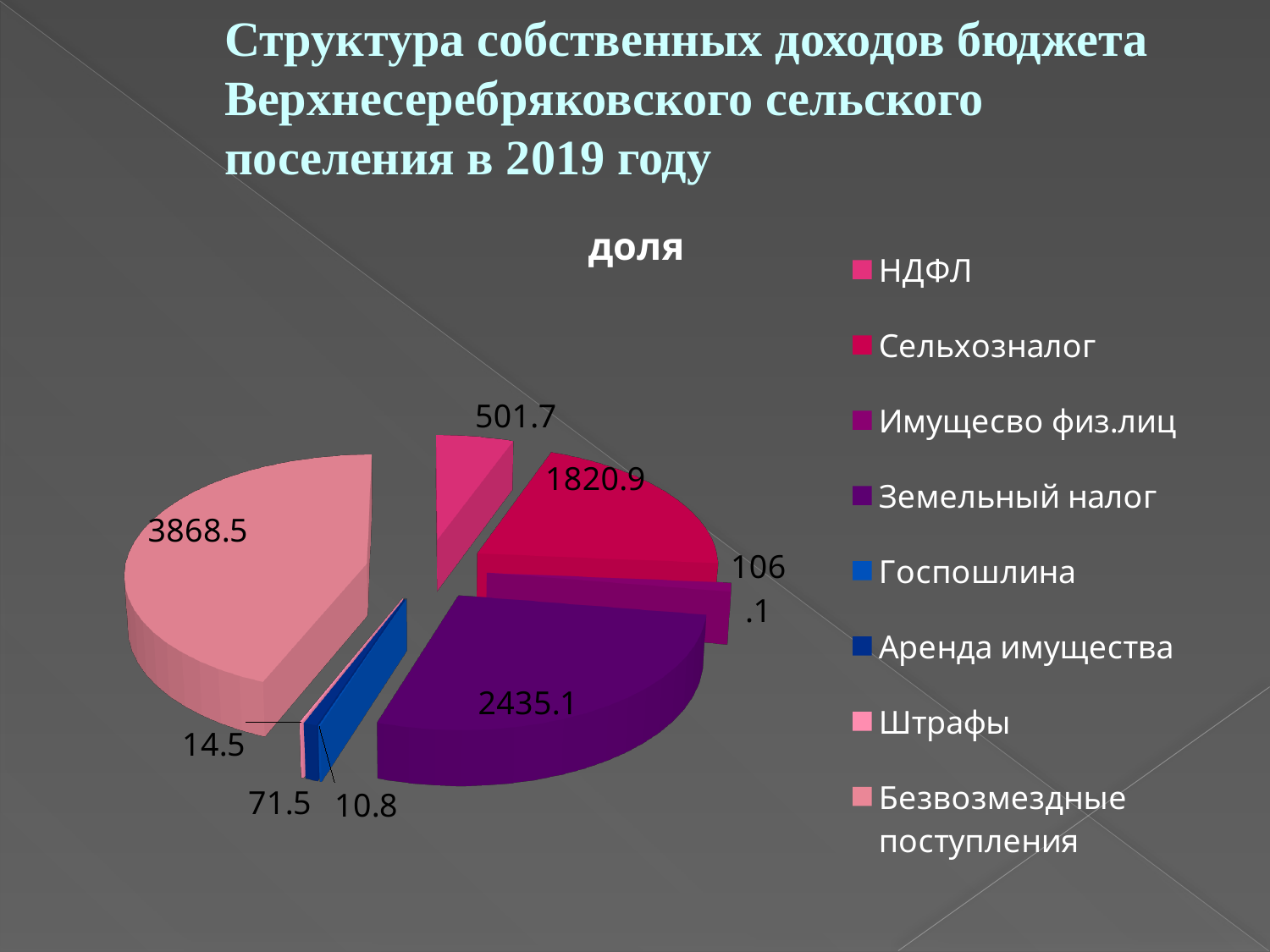
Which category has the largest slice of the pie? Безвозмездные поступления What is the value for Земельный налог? 2435.1 What is the difference between the values for Безвозмездные поступления and Земельный налог? 1433.4 What is the value for Сельхозналог? 1820.9 What kind of chart is shown on the slide? pie chart What is the value for НДФЛ? 501.7 What is the title of the chart? доля Which category has the smallest slice of the pie? Госпошлина Which is larger, the value for НДФЛ or the value for Имущесво физ.лиц? НДФЛ How many categories does the legend of the pie chart list? 8 What is the value for Безвозмездные поступления? 3868.5 What is the difference between the values for Земельный налог and Сельхозналог? 614.2